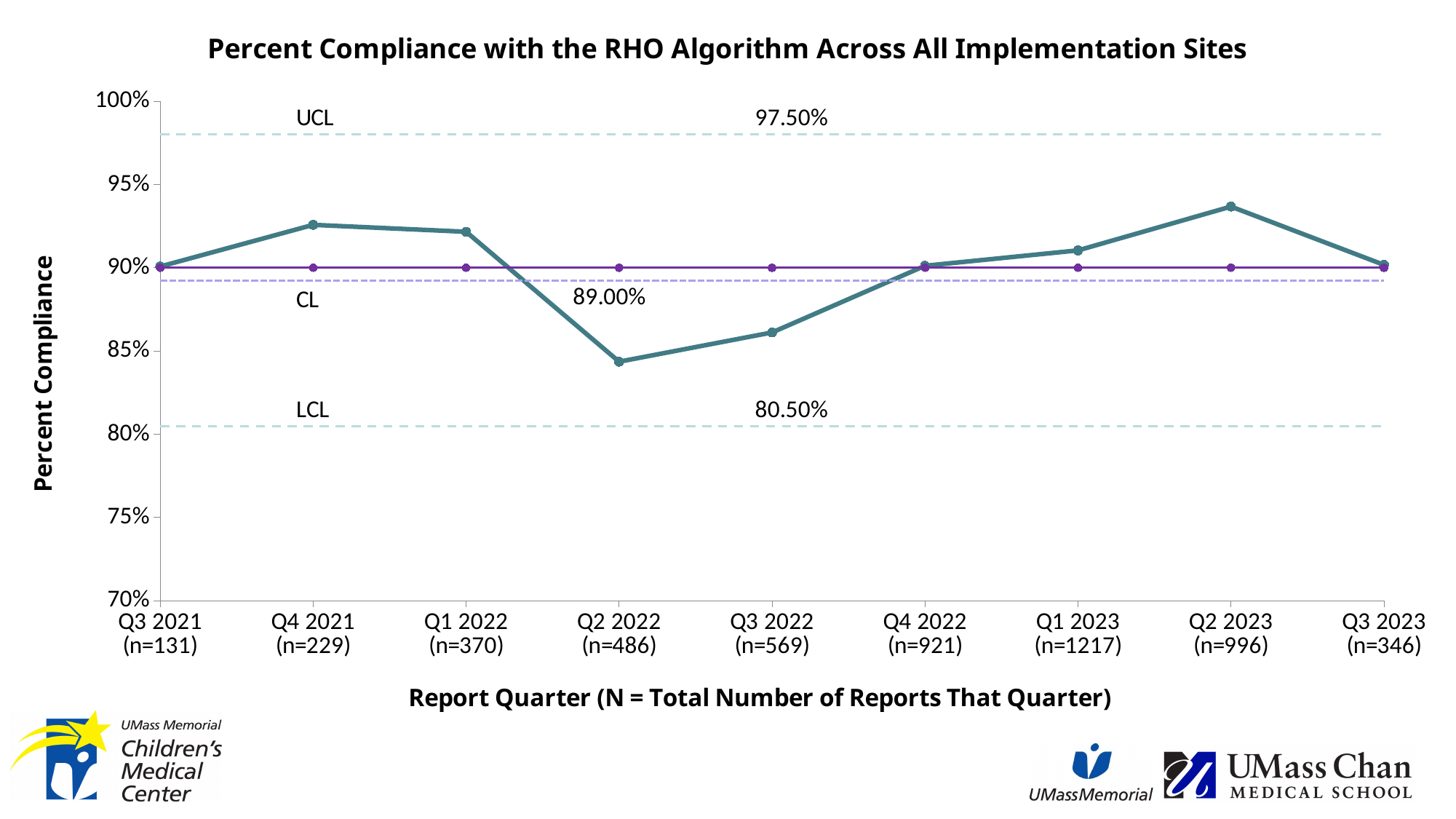
What kind of chart is shown on the slide? line chart What is the value of the LCL (lower control limit) shown on the chart? 80.50% What is the value of the CL (center line) shown on the chart? 89.00% What is the value of the UCL (upper control limit) shown on the chart? 97.50% Which quarter has higher percent compliance, Q4 2021 or Q3 2022? Q4 2021 Does percent compliance rise or fall from Q2 2022 to Q2 2023? rise Which report quarter has the lowest percent compliance? Q2 2022 Is the percent compliance for Q2 2022 greater or less than 85%? less Which report quarter has the highest percent compliance? Q2 2023 How many report quarters are plotted along the x axis? 9 What is the title of the chart? Percent Compliance with the RHO Algorithm Across All Implementation Sites Is the percent compliance for Q2 2023 greater or less than 90%? greater